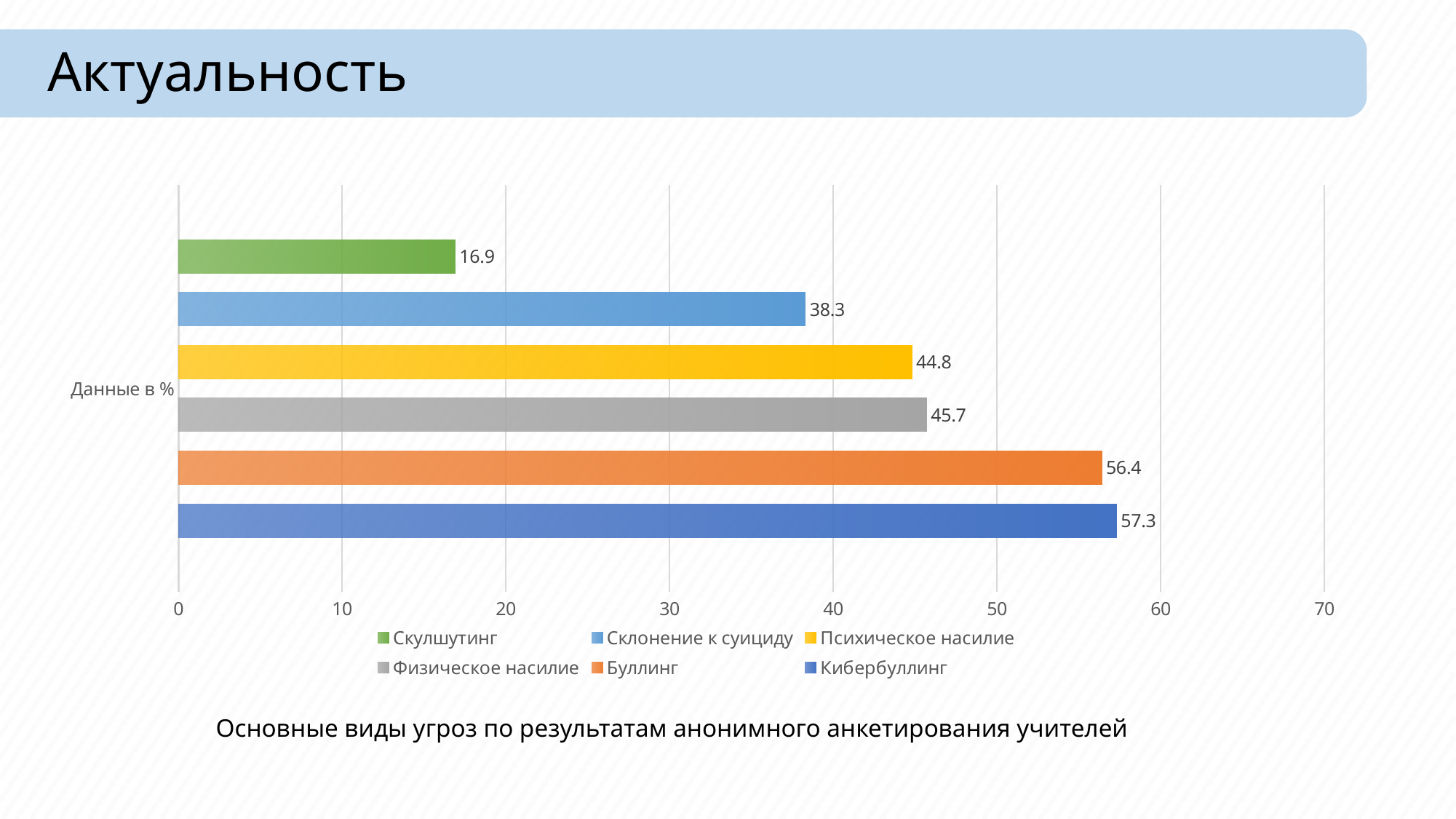
Is the value for Буллинг greater or less than 50? greater How many series does the legend list? 6 What is the value for Кибербуллинг? 57.3 Which series has the highest value? Кибербуллинг What is the label on the category axis of the chart? Данные в % Which is larger, the value for Физическое насилие or the value for Склонение к суициду? Физическое насилие What is the value for Психическое насилие? 44.8 What kind of chart is shown on the slide? bar chart What is the value for Склонение к суициду? 38.3 What is the value for Скулшутинг? 16.9 Which series has the lowest value? Скулшутинг What is the difference between the values for Буллинг and Склонение к суициду? 18.1